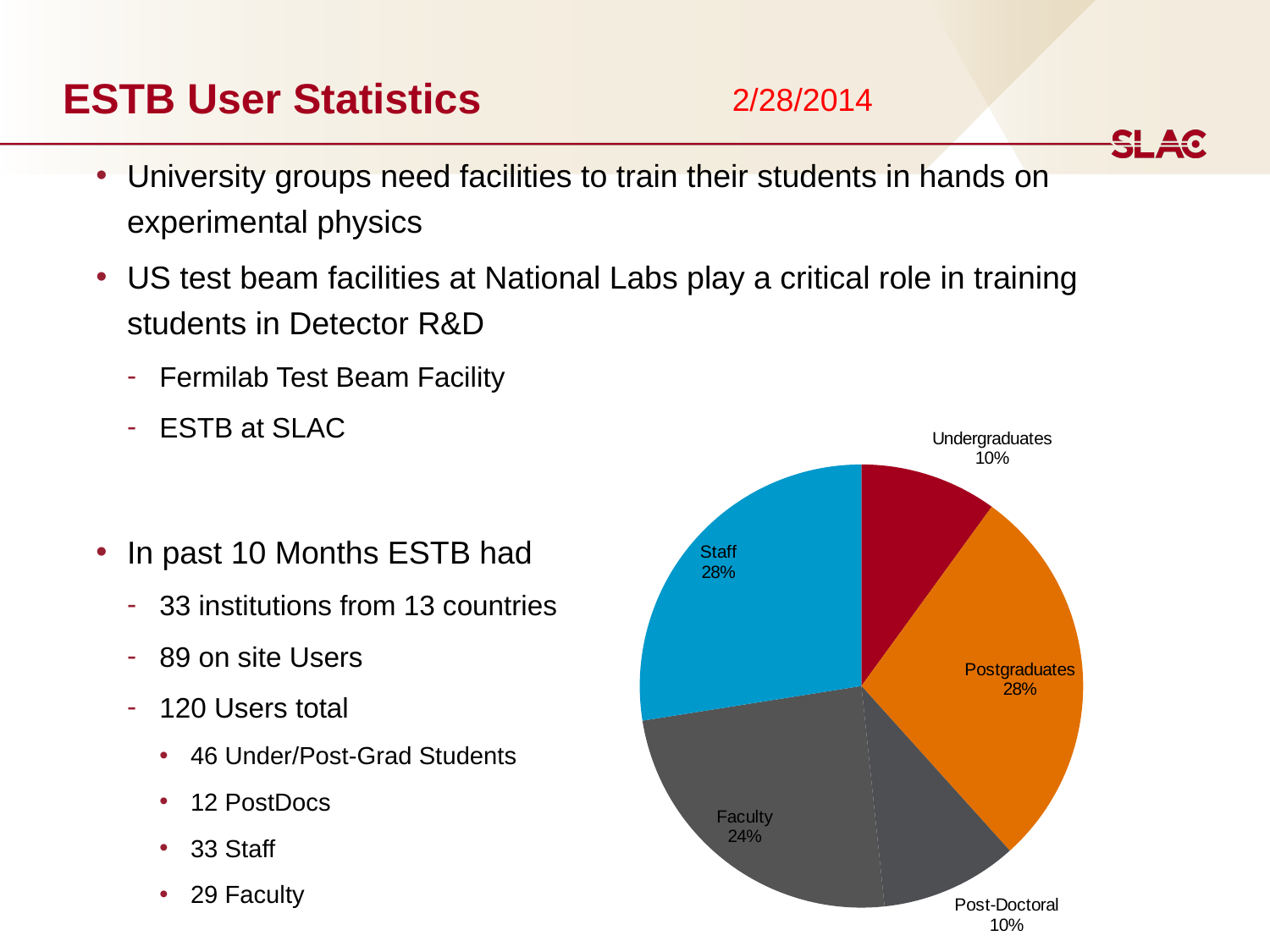
Which is larger in the pie chart, Faculty or Staff? Staff What share of the pie chart is Postgraduates? 28% Which is larger in the pie chart, Postgraduates or Post-Doctoral? Postgraduates What share of the pie chart is Undergraduates? 10% What colour is the Staff slice in the pie chart? blue What share of the pie chart is Faculty? 24% What is the difference in percentage points between Staff and Faculty in the pie chart? 4% What is the difference in percentage points between Postgraduates and Undergraduates in the pie chart? 18% How many slices does the pie chart have? 5 What type of chart is shown on the slide? pie chart